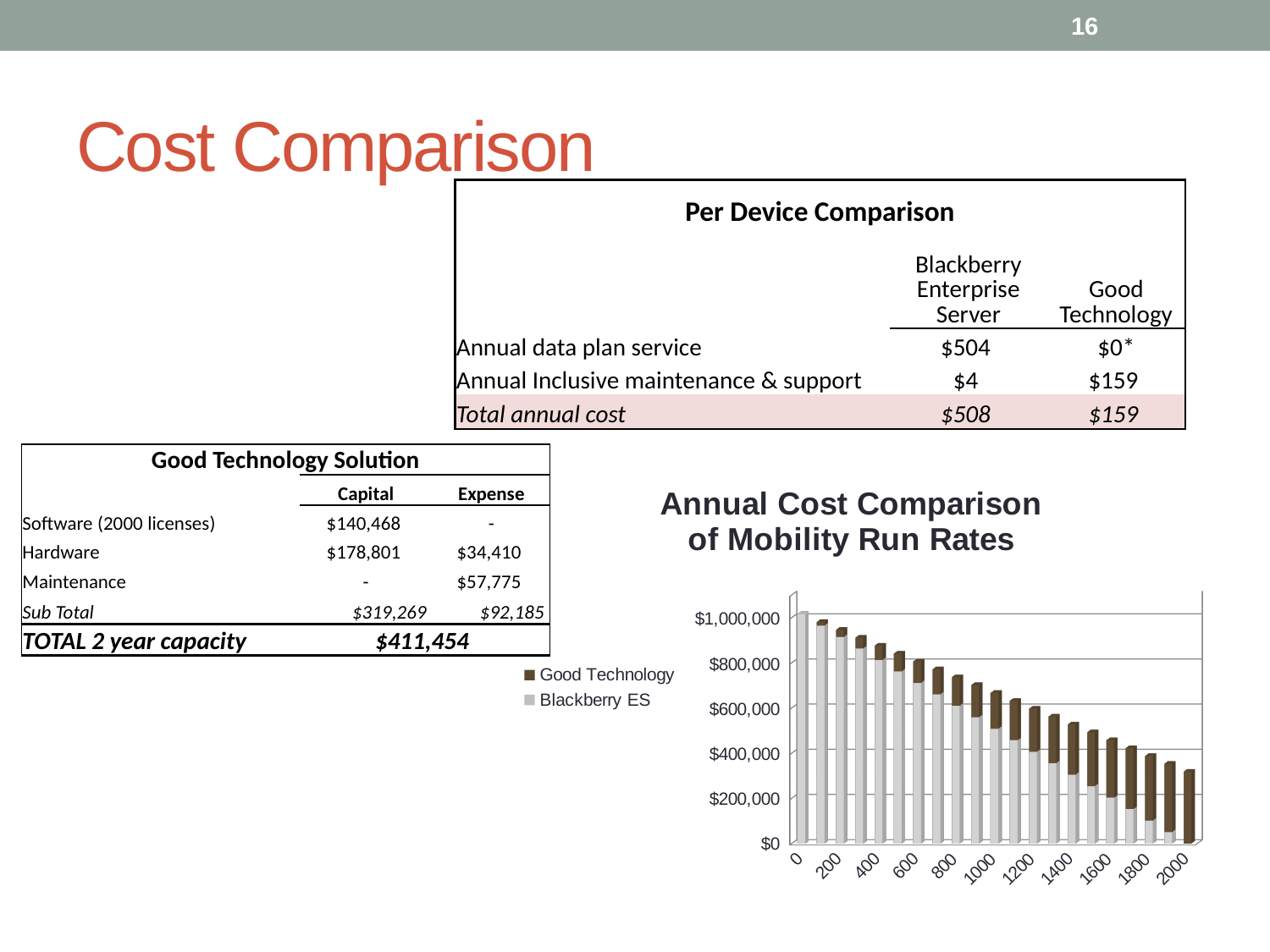
In the "Annual Cost Comparison of Mobility Run Rates" chart, is the total bar at x = 2000 greater or less than $400,000? less In the "Annual Cost Comparison of Mobility Run Rates" chart, is the total bar at x = 0 greater or less than $800,000? greater In the "Annual Cost Comparison of Mobility Run Rates" chart, at x = 0, which series has the larger value, Good Technology or Blackberry ES? Blackberry ES What kind of chart is the "Annual Cost Comparison of Mobility Run Rates" chart? Stacked bar chart In the "Annual Cost Comparison of Mobility Run Rates" chart, does the total bar height rise or fall as the x-axis value increases from 0 to 2000? Fall In the "Annual Cost Comparison of Mobility Run Rates" chart, at which x-axis value is the total bar highest? 0 In the "Annual Cost Comparison of Mobility Run Rates" chart, at which x-axis value is the total bar lowest? 2000 In the "Annual Cost Comparison of Mobility Run Rates" chart, does the Good Technology portion of the bars rise or fall as the x-axis value increases? Rise In the "Annual Cost Comparison of Mobility Run Rates" chart, does the Blackberry ES portion of the bars rise or fall as the x-axis value increases? Fall Which two series are shown in the legend of the "Annual Cost Comparison of Mobility Run Rates" chart? Good Technology and Blackberry ES In the "Annual Cost Comparison of Mobility Run Rates" chart, at x = 2000, which series has the larger value, Good Technology or Blackberry ES? Good Technology How many series does the legend of the "Annual Cost Comparison of Mobility Run Rates" chart list? 2